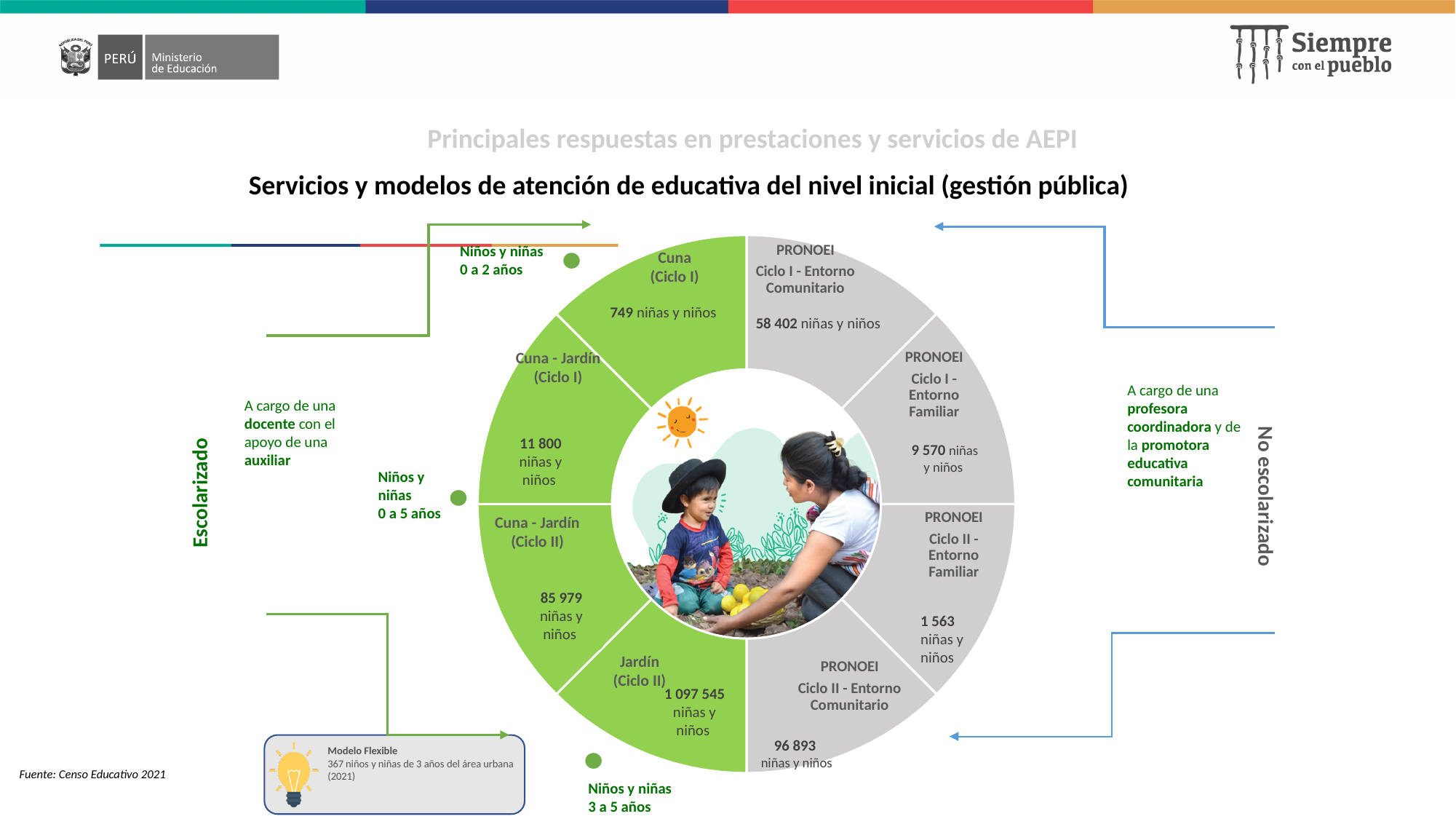
Which service in the ring chart has the lowest number of niñas y niños? Cuna (Ciclo I) How many niñas y niños are reported for Jardín (Ciclo II)? 1 097 545 How many service segments does the ring chart contain? 8 What is the difference between the number of niñas y niños in PRONOEI Ciclo II - Entorno Comunitario and PRONOEI Ciclo I - Entorno Comunitario? 38 491 Which has more niñas y niños: Cuna - Jardín (Ciclo II) or PRONOEI Ciclo II - Entorno Comunitario? PRONOEI Ciclo II - Entorno Comunitario What is the difference between the number of niñas y niños in Cuna - Jardín (Ciclo I) and Cuna (Ciclo I)? 11 051 Which colour is used for the Escolarizado segments of the ring chart? Green What kind of chart is used to show the services and models of attention? Donut chart How many niñas y niños are reported for Cuna (Ciclo I)? 749 How many niñas y niños are reported for PRONOEI Ciclo I - Entorno Comunitario? 58 402 How many niñas y niños are reported for PRONOEI Ciclo II - Entorno Familiar? 1 563 Which service in the ring chart has the highest number of niñas y niños? Jardín (Ciclo II)